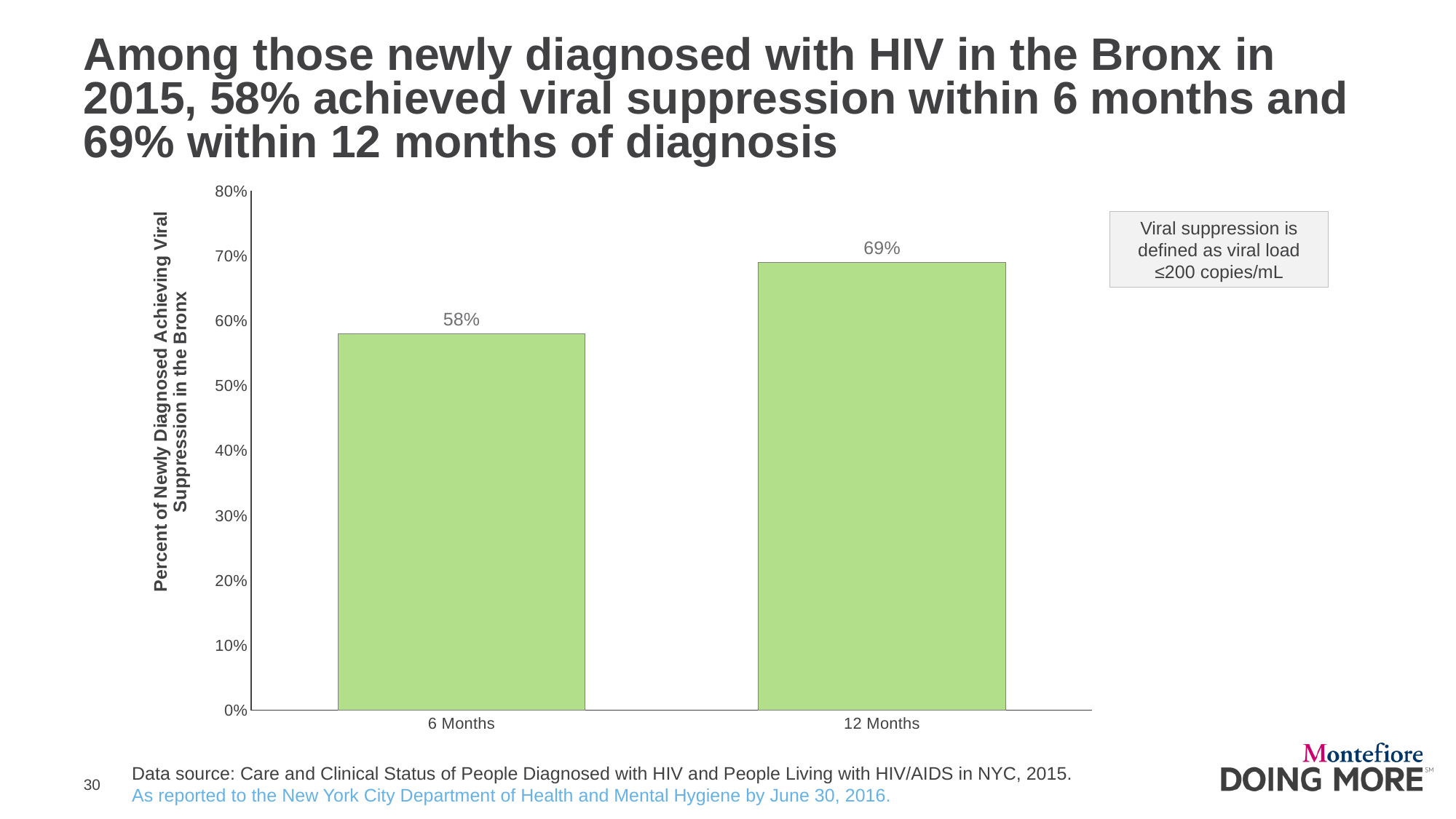
What kind of chart is shown on the slide? Bar chart What is the label of the y axis? Percent of Newly Diagnosed Achieving Viral Suppression in the Bronx How many categories are shown on the x axis? 2 Is the value for 6 Months greater or less than 60%? less Which category has the higher value, 6 Months or 12 Months? 12 Months What is the difference in percentage points between the 12 Months and 6 Months values? 11 percentage points Is the value for 12 Months greater or less than 60%? greater What is the maximum value shown on the y axis? 80% What percent of newly diagnosed people achieved viral suppression within 12 months? 69% What percent of newly diagnosed people achieved viral suppression within 6 months? 58% Which category has the lower value? 6 Months Do the values rise or fall from 6 Months to 12 Months? Rise